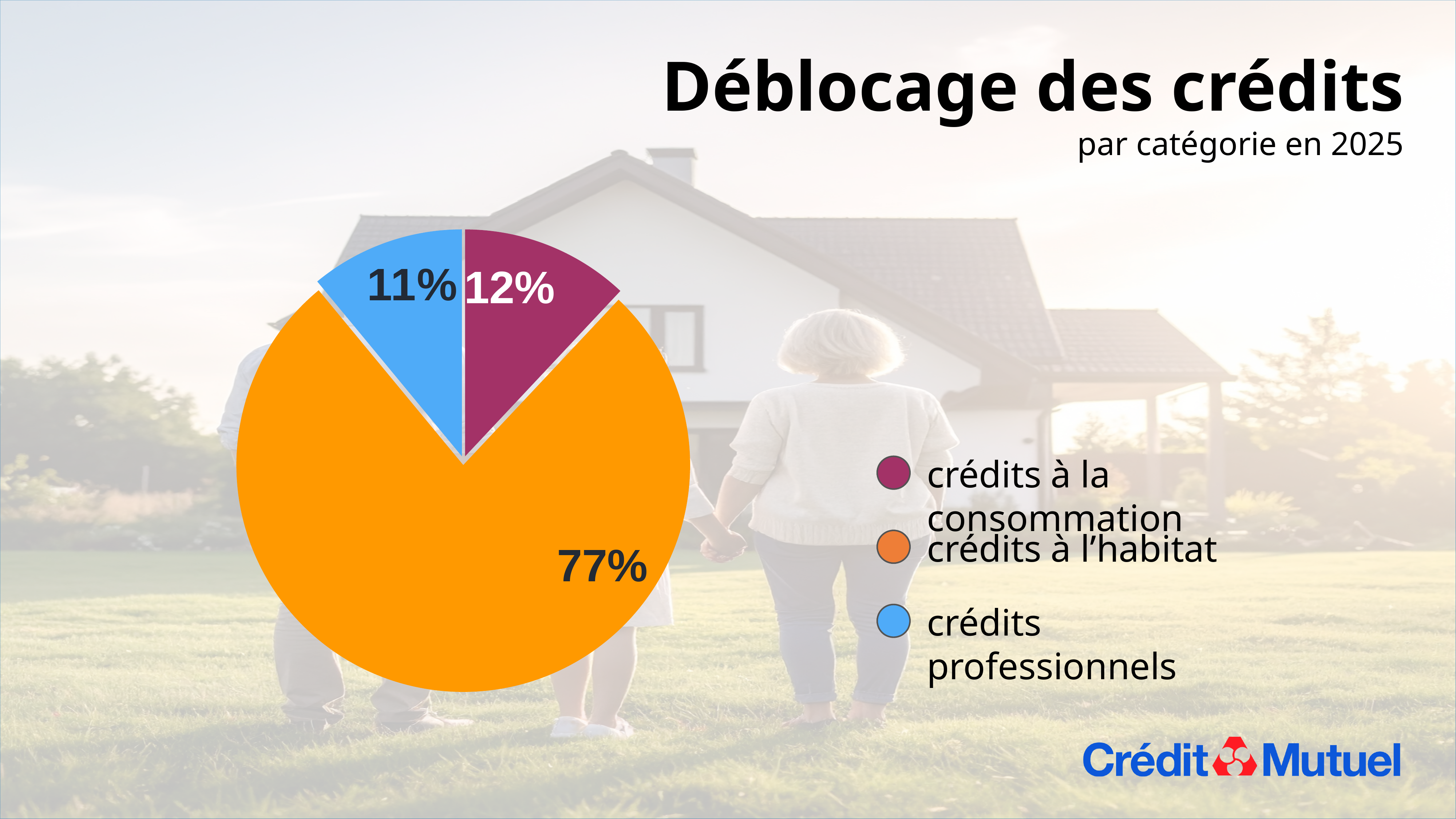
What is the title of the chart? Déblocage des crédits Which is larger, the share of crédits à l'habitat or crédits professionnels? crédits à l'habitat What kind of chart is shown on the slide? pie chart Which category has the largest share of the pie? crédits à l'habitat What colour represents crédits professionnels in the pie chart? blue Which category has the smallest share of the pie? crédits professionnels How many categories does the pie chart show? 3 What share of the pie is crédits à l'habitat? 77% What is the difference between the share of crédits à l'habitat and crédits à la consommation? 65% What share of the pie is crédits professionnels? 11% What share of the pie is crédits à la consommation? 12% What is the difference between the share of crédits à la consommation and crédits professionnels? 1%